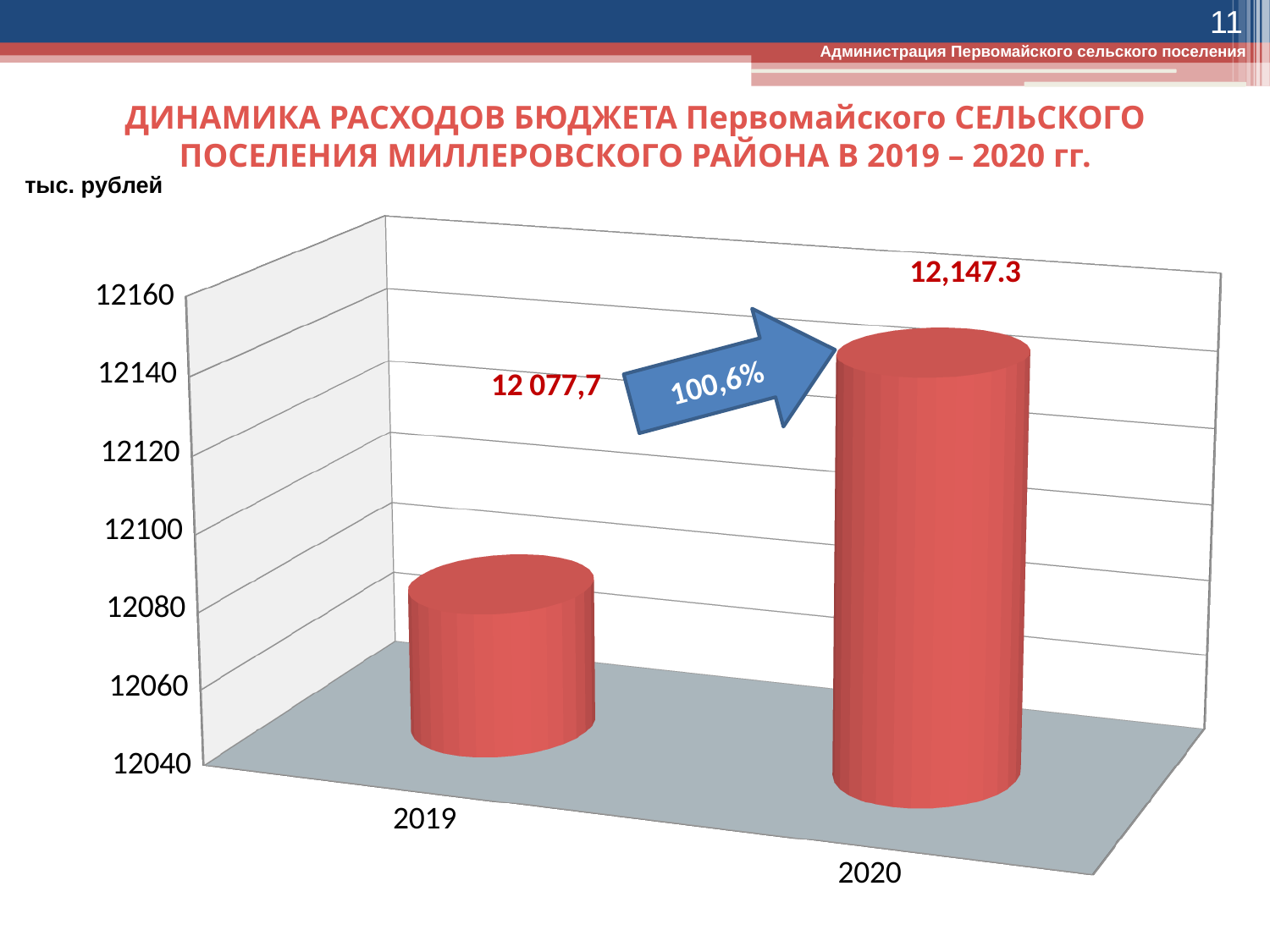
Is the value for 2019 greater or less than 12100? less Do the values rise or fall from 2019 to 2020? Rise By how much does the 2020 value exceed the 2019 value? 69.6 What is the budget expenditure value shown for 2019? 12 077,7 Is the value for 2020 larger than the value for 2019? Yes What kind of chart is shown on the slide? Bar chart How many years (categories) are plotted on the chart? 2 Which year has the lower budget expenditure? 2019 What is the budget expenditure value shown for 2020? 12,147.3 Which year has the higher budget expenditure? 2020 Is the value for 2020 greater or less than 12120? greater What percentage is written on the arrow between the two bars? 100,6%